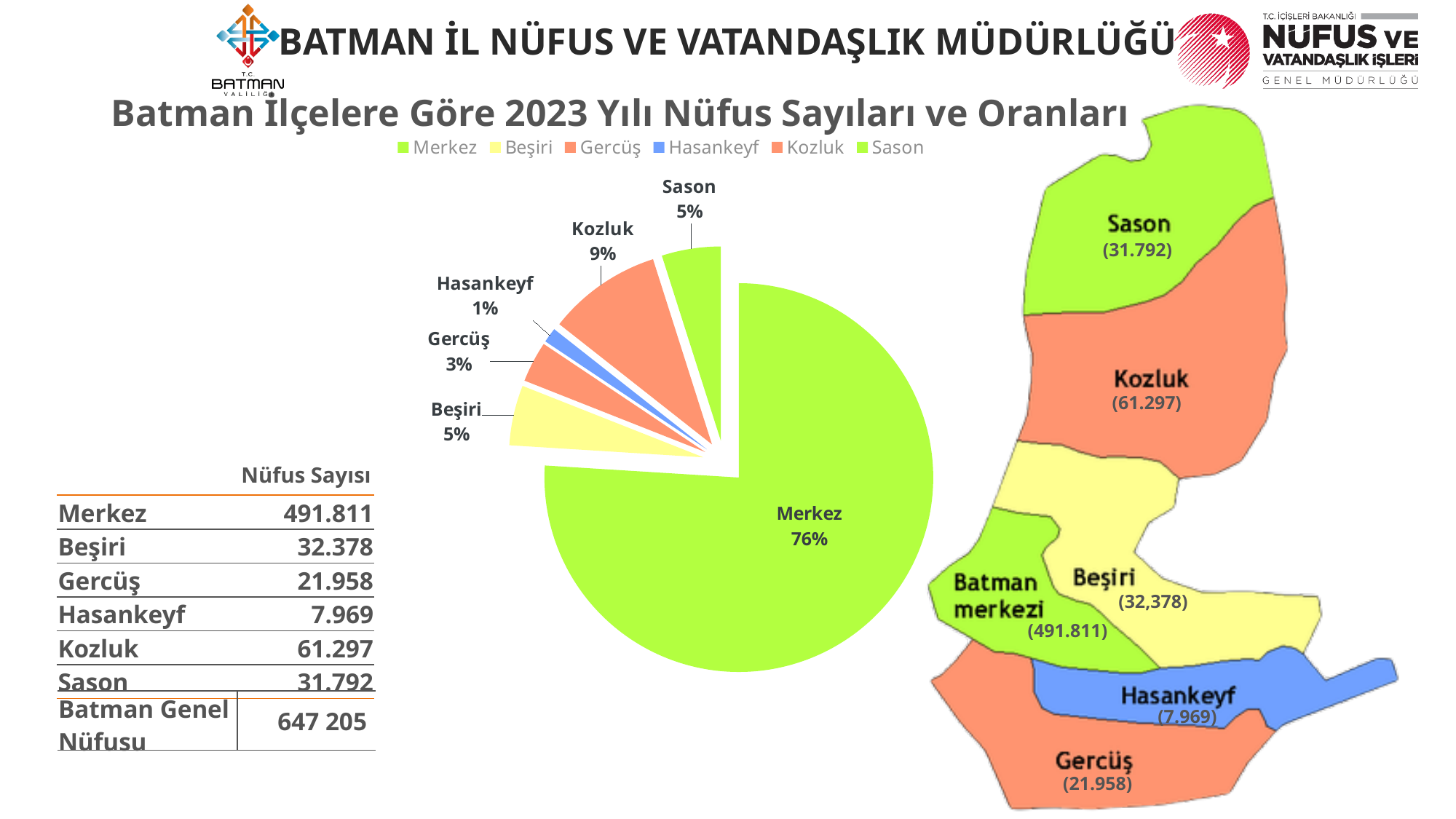
How many slices does the pie chart have? 6 What percentage is shown for Kozluk in the pie chart? 9% How many entries does the chart legend list? 6 What is the title of the chart on the slide? Batman İlçelere Göre 2023 Yılı Nüfus Sayıları ve Oranları Which district has the largest slice in the pie chart? Merkez What is the difference in percentage points between the Kozluk and Beşiri slices? 4 Which district has the smallest slice in the pie chart? Hasankeyf What share of the pie does Merkez represent? 76% What percentage is shown for Hasankeyf in the pie chart? 1% What type of chart is shown on the slide? pie chart What percentage is shown for Gercüş in the pie chart? 3% Which has a larger share in the pie chart, Kozluk or Gercüş? Kozluk